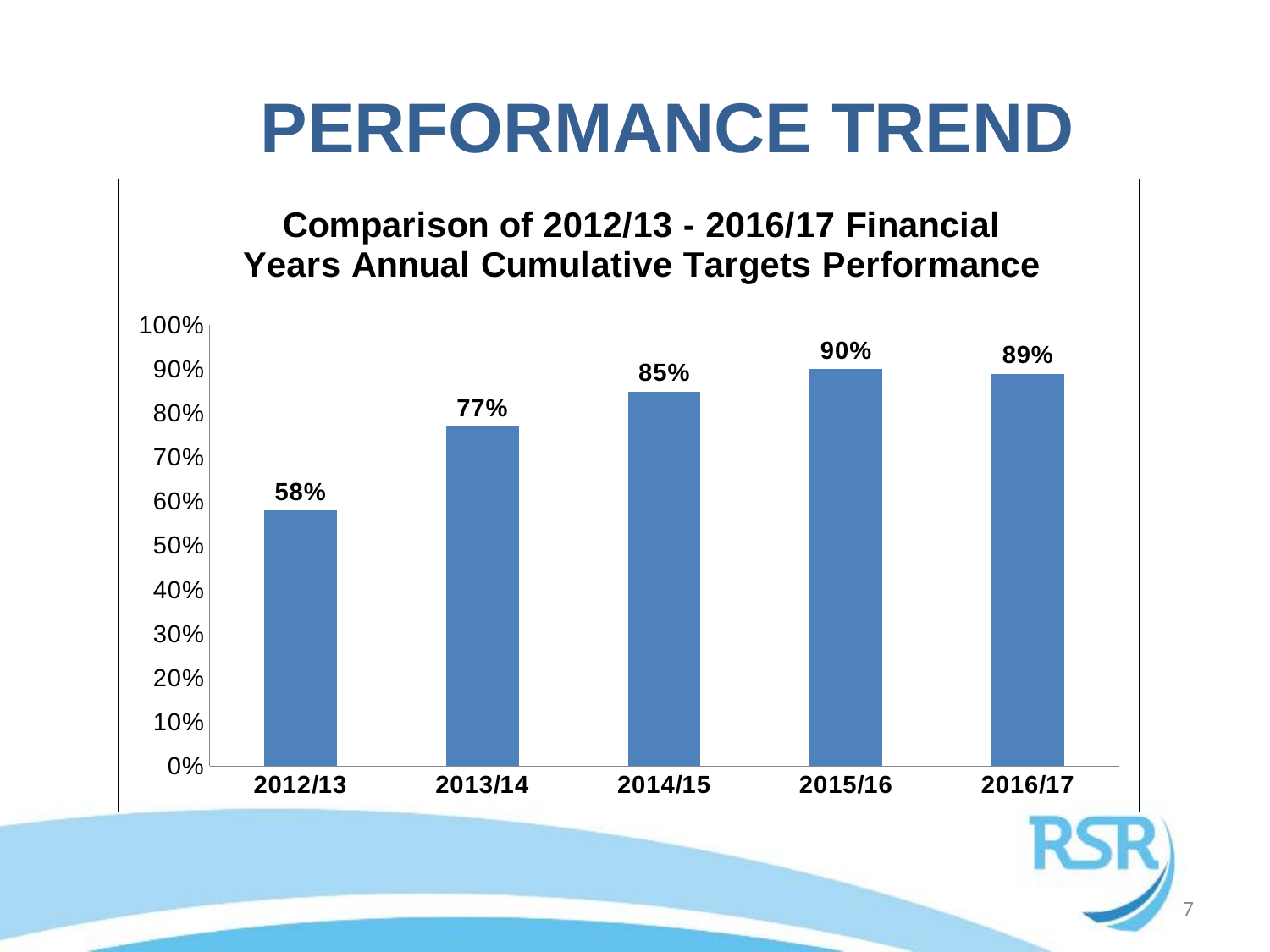
What is the value for 2014/15? 85% Which financial year has the highest value? 2015/16 How many financial years are shown on the chart? 5 What is the title of the chart? Comparison of 2012/13 - 2016/17 Financial Years Annual Cumulative Targets Performance Which is larger, the value for 2013/14 or the value for 2014/15? 2014/15 What kind of chart is shown on the slide? Bar chart Is the value for 2013/14 greater or less than 70%? greater What is the difference between the values for 2015/16 and 2016/17? 1% What is the difference between the values for 2013/14 and 2012/13? 19% What is the value for 2016/17? 89% What is the value for 2012/13? 58% Which financial year has the lowest value? 2012/13